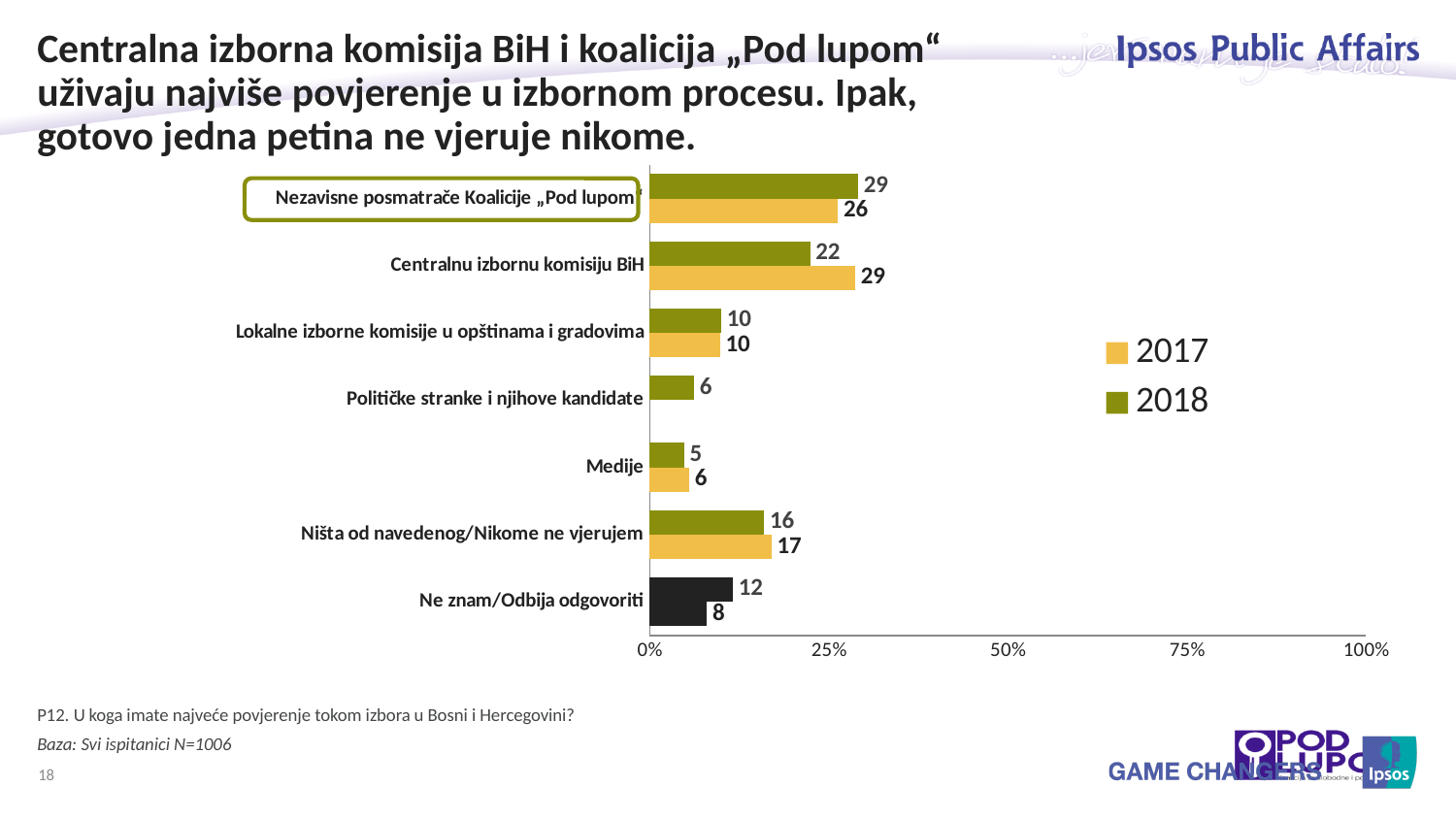
Which category has the highest 2018 value? Nezavisne posmatrače Koalicije „Pod lupom“ What is the difference between the 2017 and 2018 values for Centralnu izbornu komisiju BiH? 7 What kind of chart is shown on the slide? Bar chart What is the 2018 value for Centralnu izbornu komisiju BiH? 22 What is the 2018 value for Lokalne izborne komisije u opštinama i gradovima? 10 How many categories are shown on the chart? 7 For Medije, which year has the larger value, 2017 or 2018? 2017 How many series does the legend list? 2 Which category has the highest 2017 value? Centralnu izbornu komisiju BiH What is the 2017 value for Nezavisne posmatrače Koalicije „Pod lupom“? 26 What is the 2017 value for Ništa od navedenog/Nikome ne vjerujem? 17 Which category has the lowest 2018 value? Medije